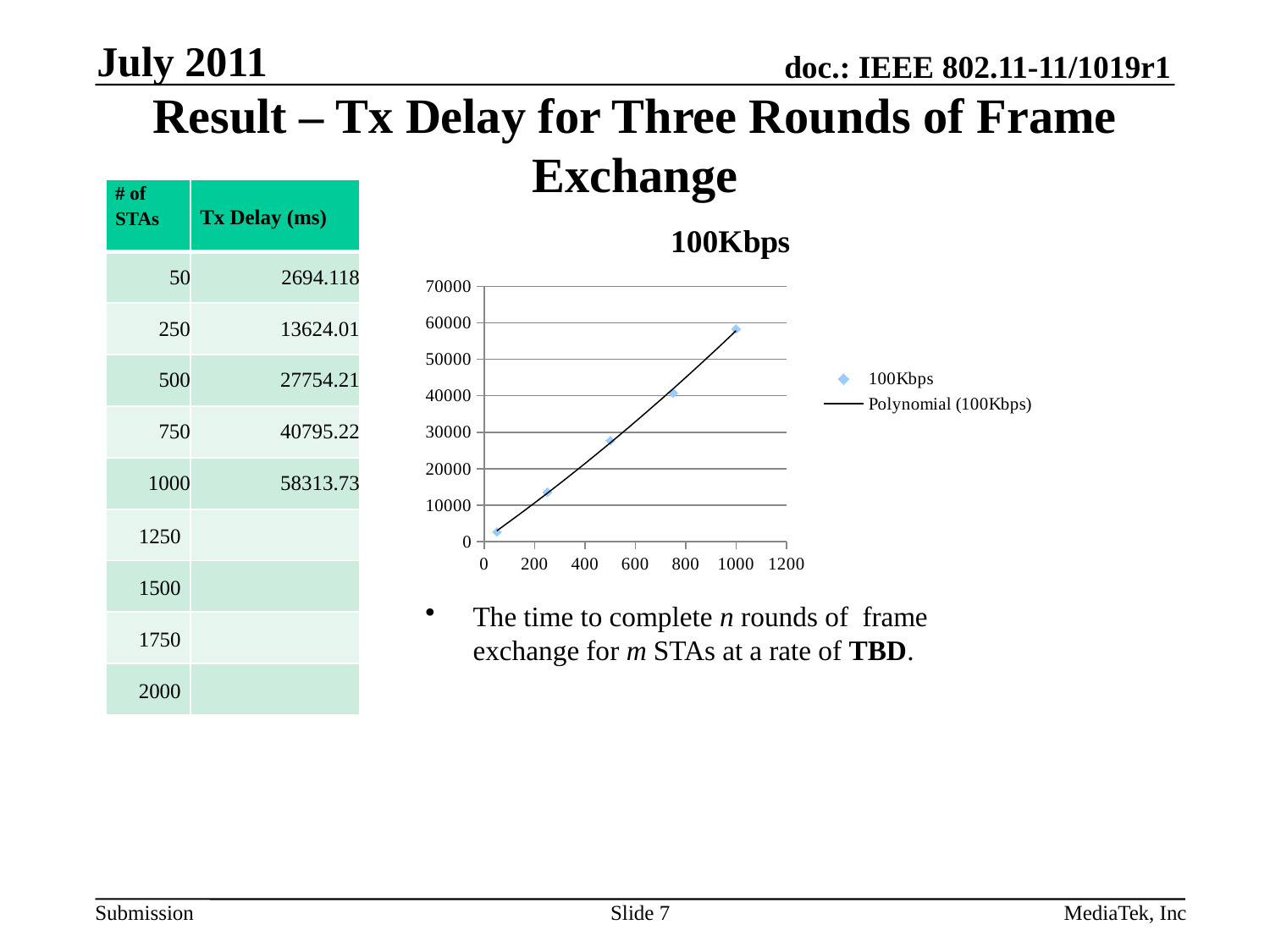
In the 100Kbps chart, is the value at x = 1000 greater or less than 60000? less In the 100Kbps chart, do the values rise or fall as the x-axis value increases? rise What kind of chart is shown under the title "100Kbps"? scatter chart What is the name of the trend line entry in the legend of the 100Kbps chart? Polynomial (100Kbps) In the 100Kbps chart, is the value at x = 500 greater or less than 20000? greater In the 100Kbps chart, at which x-axis value is the plotted point highest? 1000 In the 100Kbps chart, is the value at x = 50 greater or less than 10000? less How many data points are plotted in the 100Kbps chart? 5 In the 100Kbps chart, at which x-axis value is the plotted point lowest? 50 How many entries does the legend of the 100Kbps chart list? 2 What is the highest tick value shown on the y-axis of the 100Kbps chart? 70000